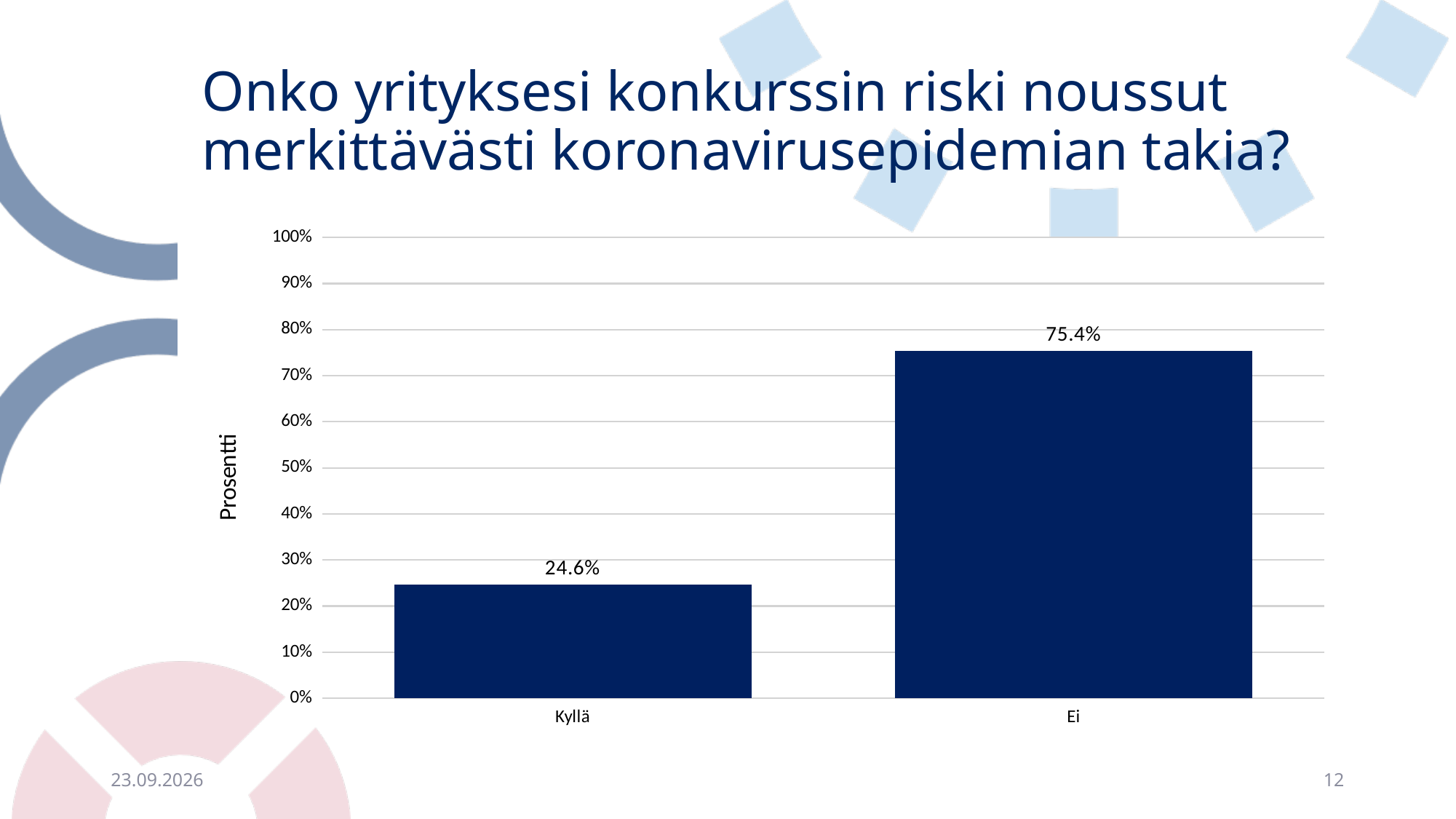
Which is larger, the value for Kyllä or the value for Ei? Ei What kind of chart is shown on the slide? bar chart Is the value for Kyllä greater or less than 30%? less Which category has the lowest value? Kyllä Which category has the highest value? Ei How many categories are shown on the x axis? 2 What is the value for Kyllä? 24.6% Is the value for Ei greater or less than 70%? greater What is the label of the vertical axis? Prosentti What is the value for Ei? 75.4% What is the highest tick value shown on the vertical axis? 100% What is the difference between the values for Ei and Kyllä? 50.8%